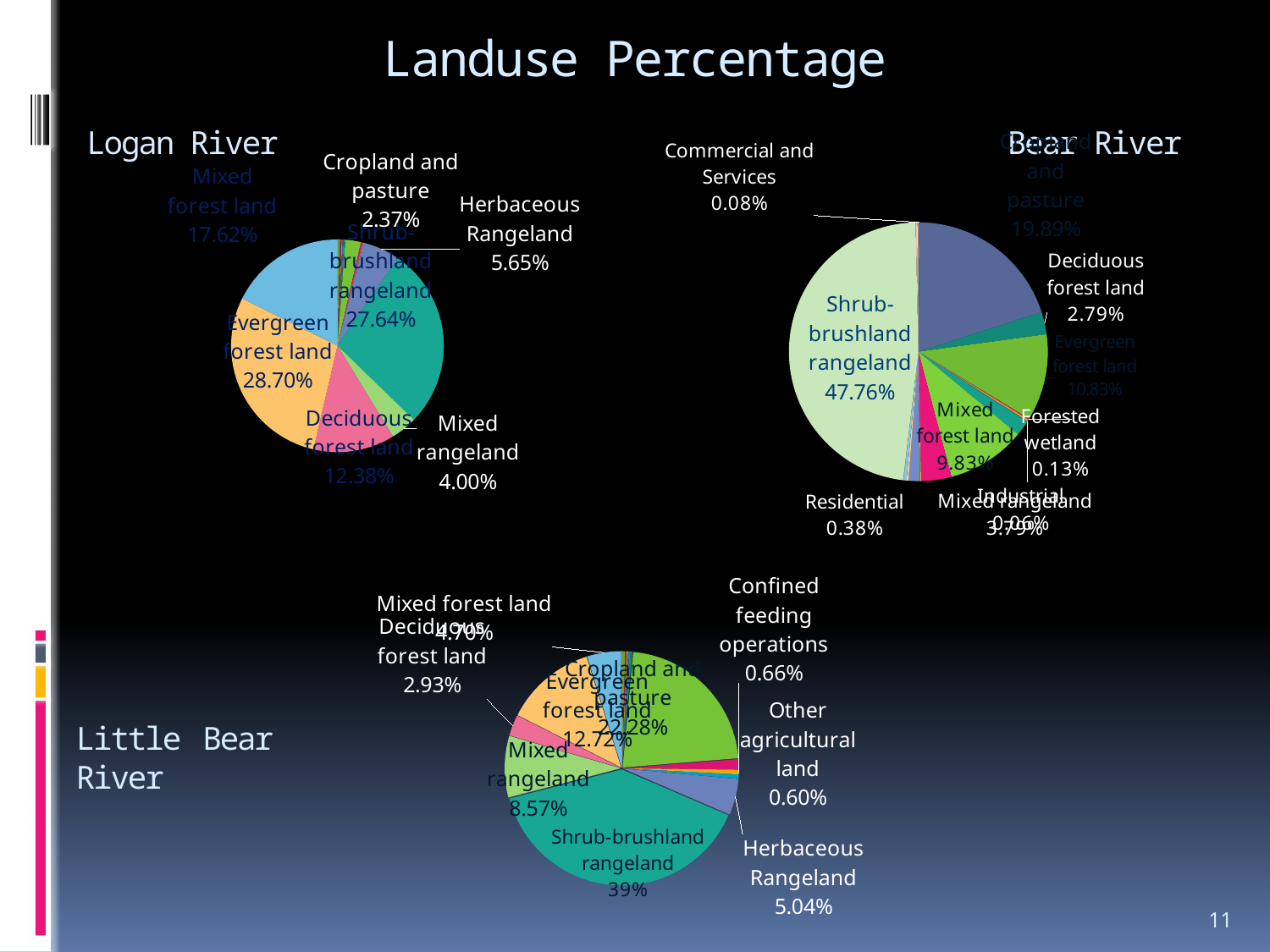
In the Little Bear River chart, what percentage is Herbaceous Rangeland? 5.04% In the Bear River chart, what percentage is Deciduous forest land? 2.79% In the Bear River chart, what percentage is Commercial and Services? 0.08% In the Bear River chart, which landuse category has the largest share? Shrub-brushland rangeland What kind of chart is used for the Logan River landuse data? pie chart In the Little Bear River chart, what is the difference between Mixed rangeland (8.57%) and Mixed forest land (4.70%)? 3.87% In the Logan River chart, what percentage is Mixed rangeland? 4.00% In the Logan River chart, which is larger: Herbaceous Rangeland or Cropland and pasture? Herbaceous Rangeland In the Little Bear River chart, what percentage is Shrub-brushland rangeland? 39% In the Logan River chart, what percentage is Shrub-brushland rangeland? 27.64% In the Logan River chart, what percentage is Evergreen forest land? 28.70% In the Bear River chart, what percentage is Shrub-brushland rangeland? 47.76%